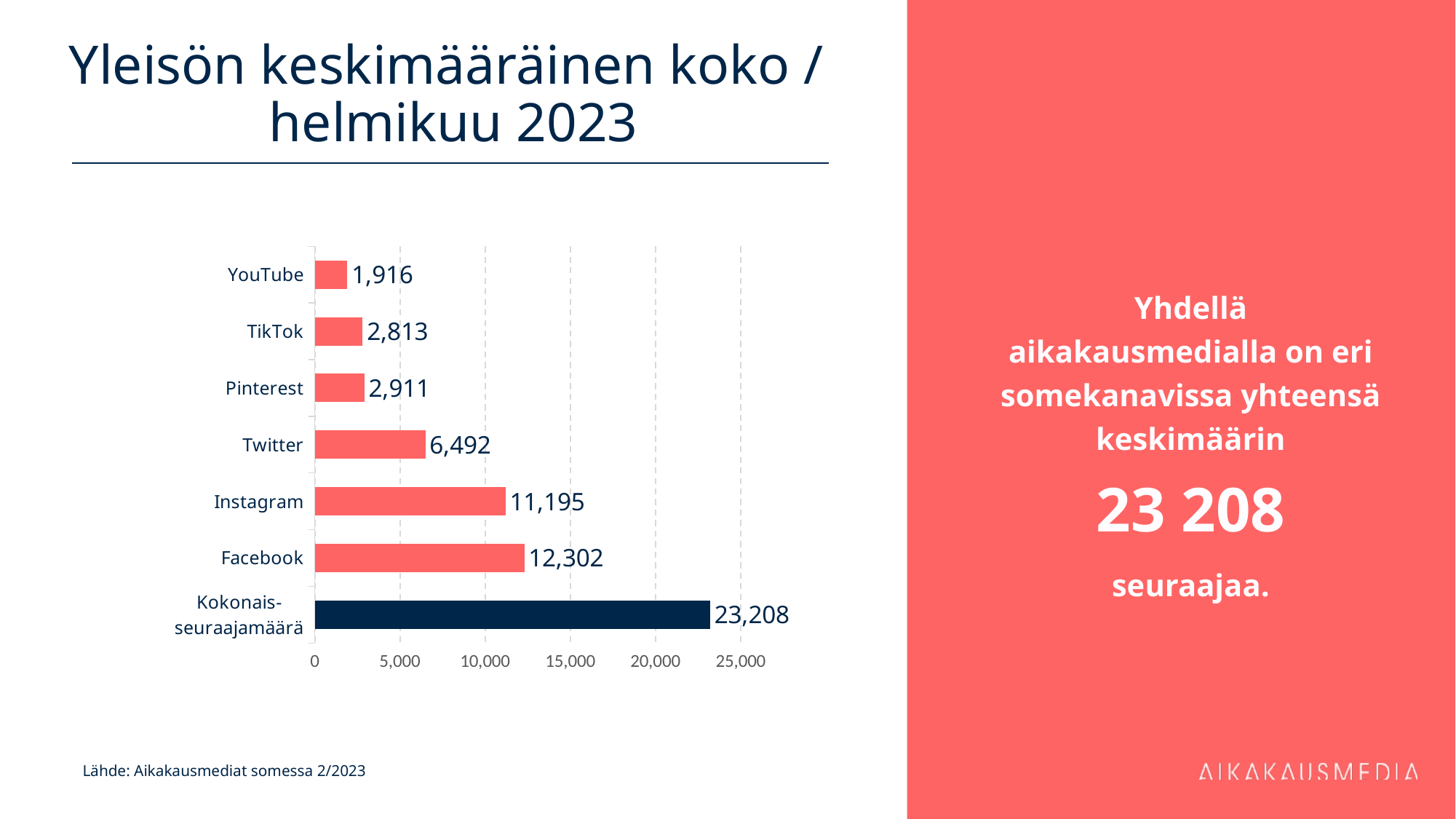
What is the value for Facebook? 12,302 Which category has the lowest value? YouTube Among the individual social media channels (excluding Kokonais-seuraajamäärä), which has the highest value? Facebook What is the value for YouTube? 1,916 Which is larger, the value for Pinterest or the value for TikTok? Pinterest What is the value for Kokonais-seuraajamäärä? 23,208 What is the difference between the values for Twitter and TikTok? 3,679 How many categories are shown in the chart? 7 What kind of chart is shown on the slide? bar chart What is the value for Instagram? 11,195 Is the value for Twitter greater or less than 5,000? greater What is the difference between the values for Facebook and Instagram? 1,107